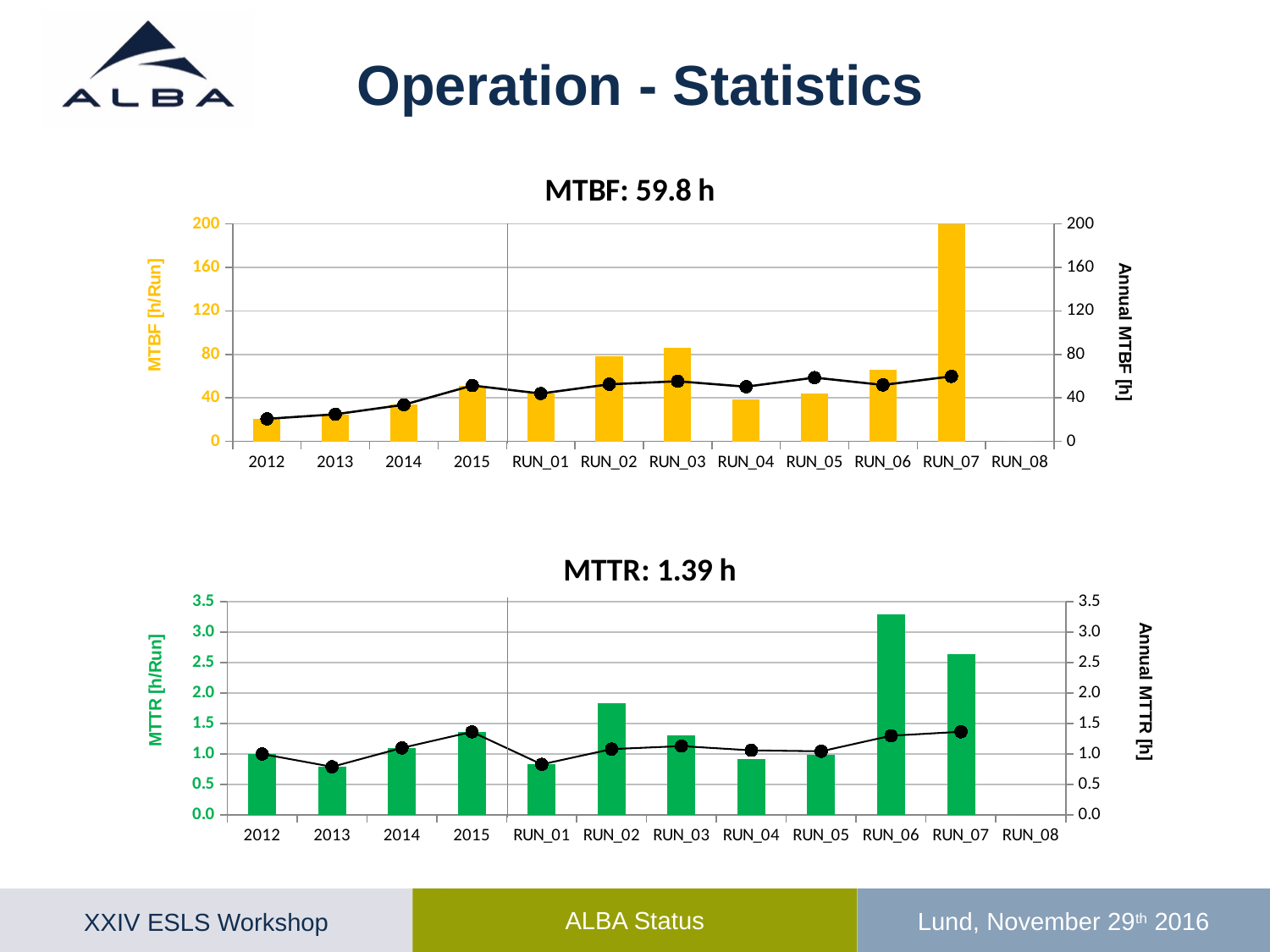
In the top chart (MTBF: 59.8 h), is the bar for RUN_06 greater or less than 40? greater In the top chart (MTBF: 59.8 h), is the bar for RUN_07 greater or less than 160? greater In the bottom chart (MTTR: 1.39 h), is the bar for RUN_06 greater or less than 3.0? greater In the bottom chart (MTTR: 1.39 h), which category has the highest bar? RUN_06 In the bottom chart (MTTR: 1.39 h), which bar is taller, RUN_06 or RUN_07? RUN_06 What kind of chart is the bottom chart (MTTR: 1.39 h)? Bar chart with a line overlay What is the label of the right-hand y axis of the top chart? Annual MTBF [h] In the top chart (MTBF: 59.8 h), which category has the lowest bar? 2012 How many categories are shown on the x axis of the top chart (MTBF: 59.8 h)? 12 In the top chart (MTBF: 59.8 h), which category has the highest bar? RUN_07